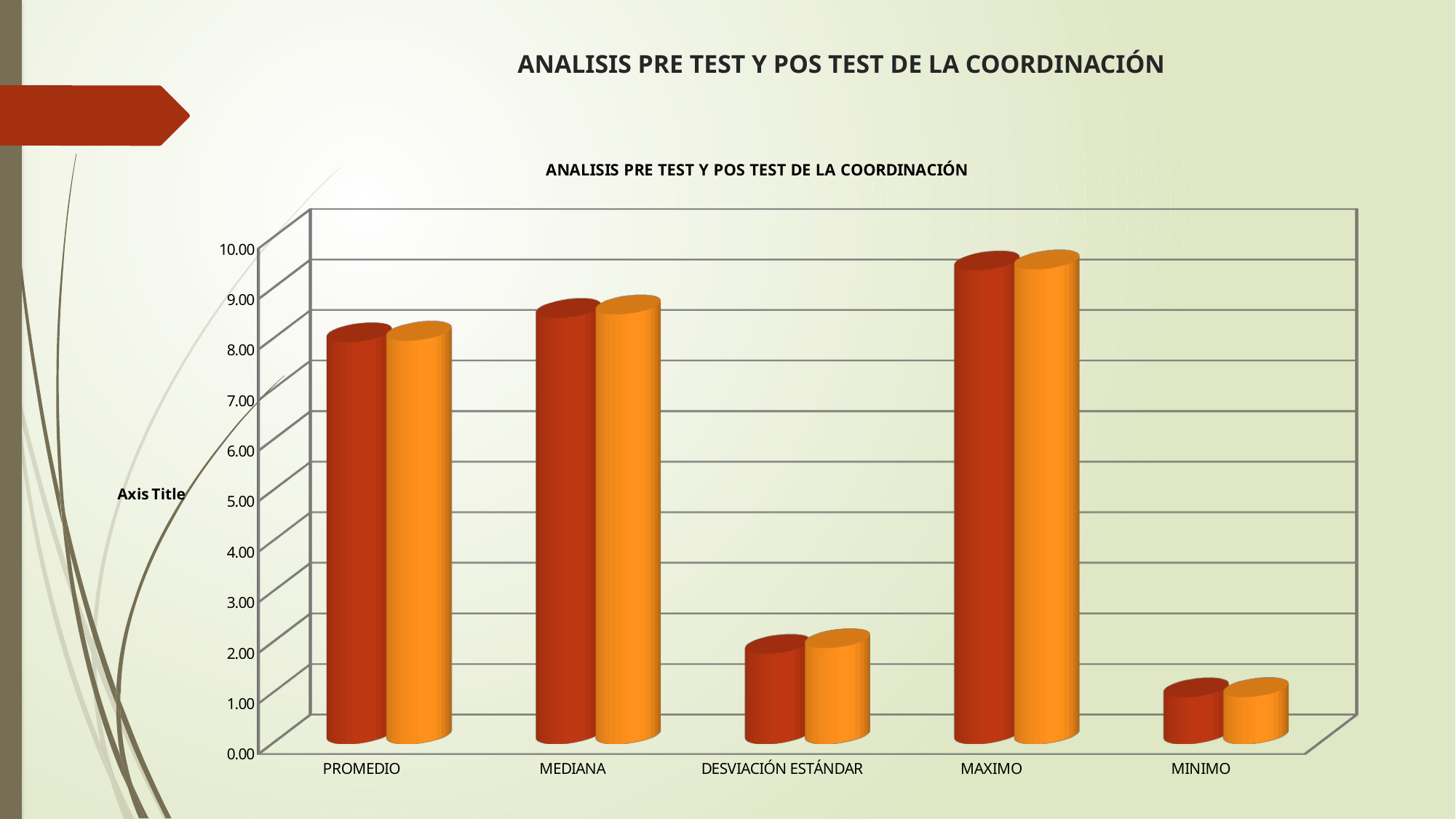
How many bars are shown for each category in the chart? 2 Which category has the lowest bars in the chart? MINIMO Is the value for MEDIANA greater or less than 7.00? greater Which is larger, the value for MEDIANA or the value for DESVIACIÓN ESTÁNDAR? MEDIANA Is the value for DESVIACIÓN ESTÁNDAR greater or less than 3.00? less What kind of chart is shown on the slide? bar chart Is the value for MINIMO greater or less than 2.00? less How many categories are shown on the x axis of the chart? 5 Which category has the highest bars in the chart? MAXIMO What is the title of the chart? ANALISIS PRE TEST Y POS TEST DE LA COORDINACIÓN